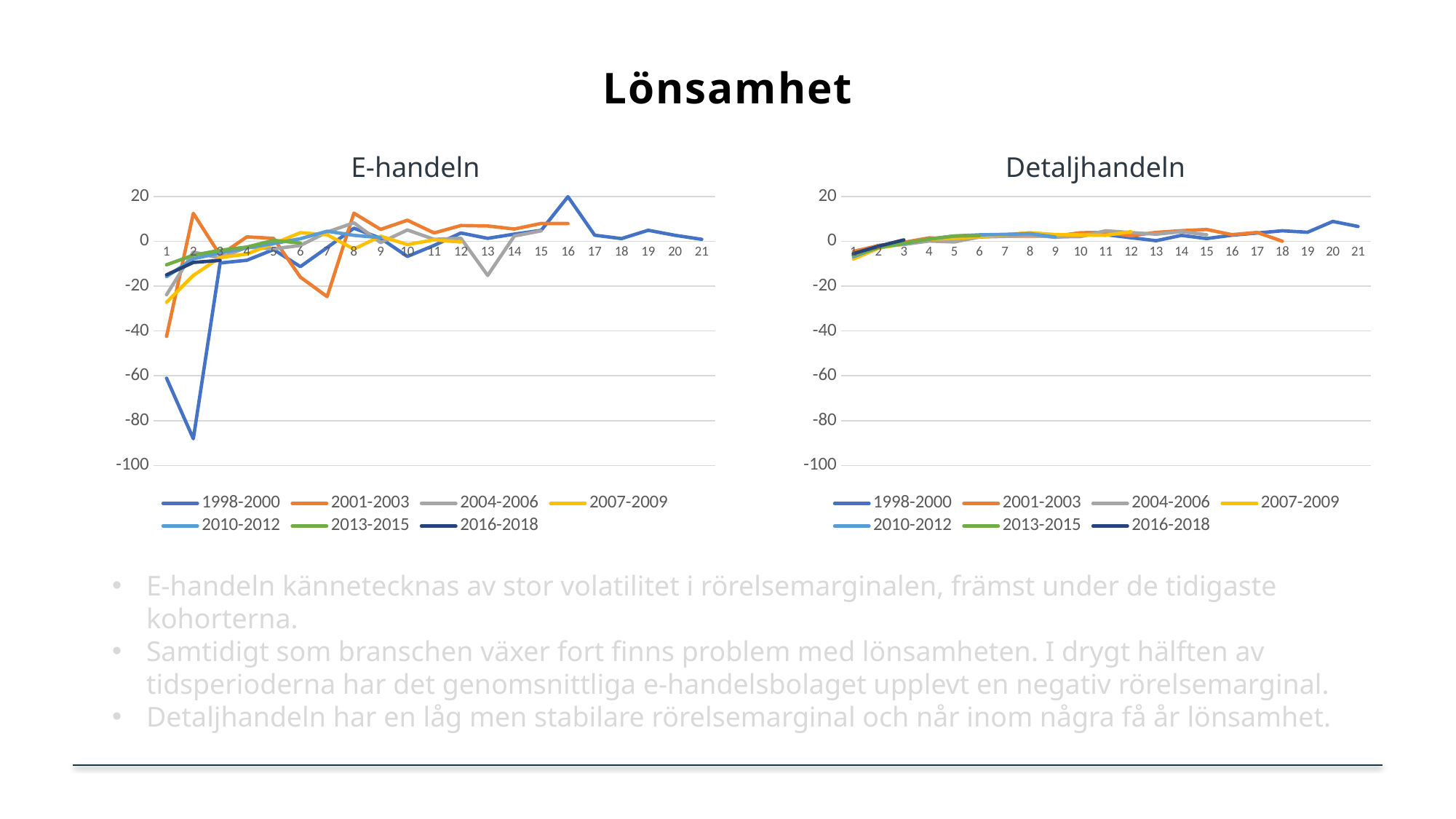
In the E-handeln chart, is the value for the 2001-2003 series at point 1 greater or less than -40? less What kind of chart is the E-handeln chart? line chart In the E-handeln chart, is the value for the 2001-2003 series at point 7 greater or less than -20? less How many series does the legend of the Detaljhandeln chart list? 7 In the E-handeln chart, does the 1998-2000 series rise or fall between point 2 and point 3? rise In the E-handeln chart, which series reaches the highest value? 1998-2000 In the E-handeln chart, which series reaches the lowest value? 1998-2000 In the E-handeln chart, is the value for the 1998-2000 series at point 2 greater or less than -80? less How many points are labelled on the x axis of the E-handeln chart? 21 What is the title of the chart on the right side of the slide? Detaljhandeln